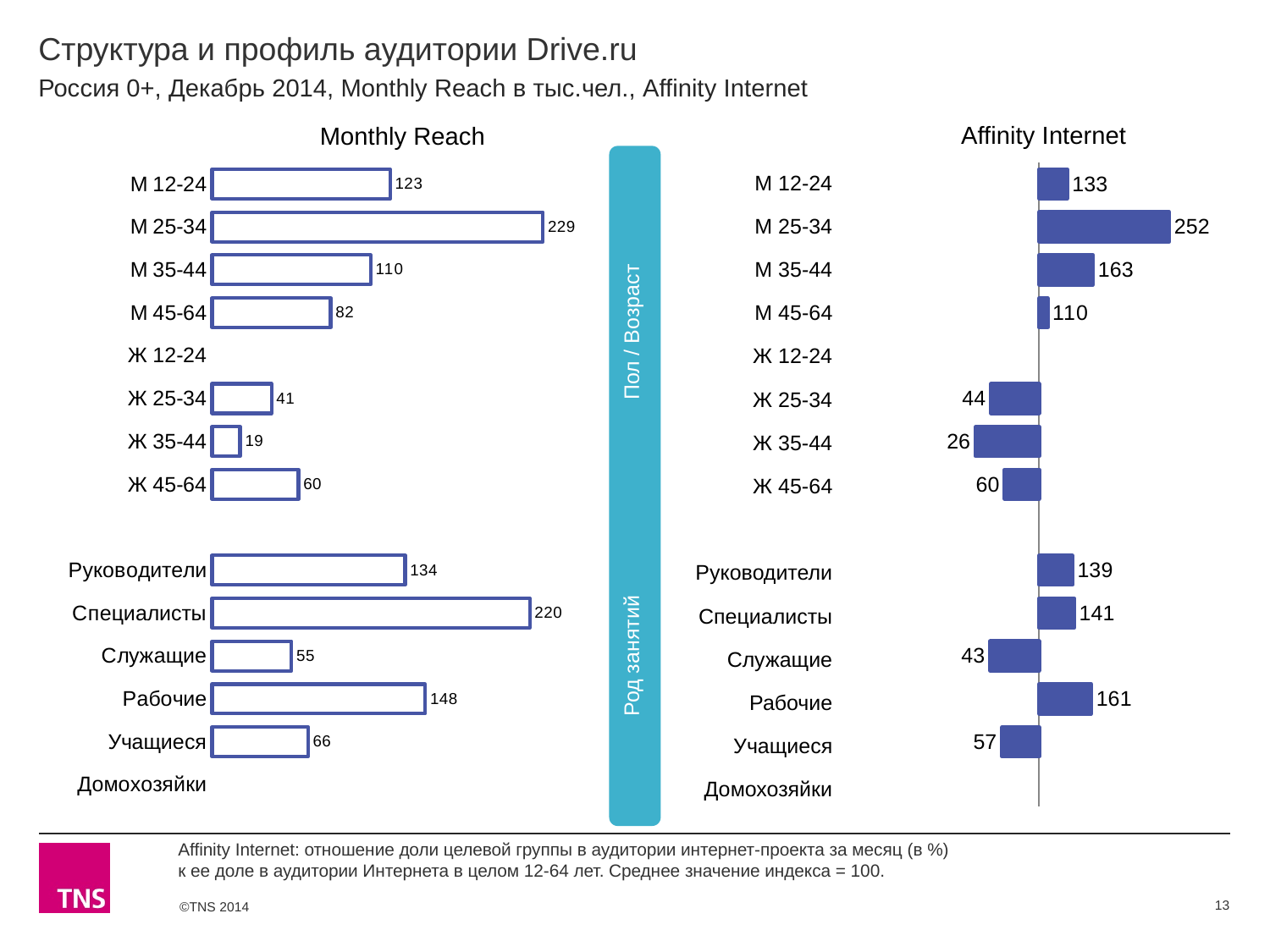
In the Affinity Internet chart, which is larger: Ж 25-34 or Ж 45-64? Ж 45-64 In the Monthly Reach chart, what is the value for Ж 35-44? 19 In the Monthly Reach chart, which is larger: Рабочие or Руководители? Рабочие What kind of chart is the Monthly Reach chart? Bar chart In the Affinity Internet chart, what is the value for Служащие? 43 In the Affinity Internet chart, what is the value for Рабочие? 161 In the Monthly Reach chart, what is the value for М 25-34? 229 In the Monthly Reach chart, what is the difference between Специалисты and Руководители? 86 In the Monthly Reach chart, which labelled category has the lowest value? Ж 35-44 In the Affinity Internet chart, what is the difference between М 35-44 and М 45-64? 53 In the Affinity Internet chart, which category has the highest value? М 25-34 What is the title of the chart on the right side of the slide? Affinity Internet